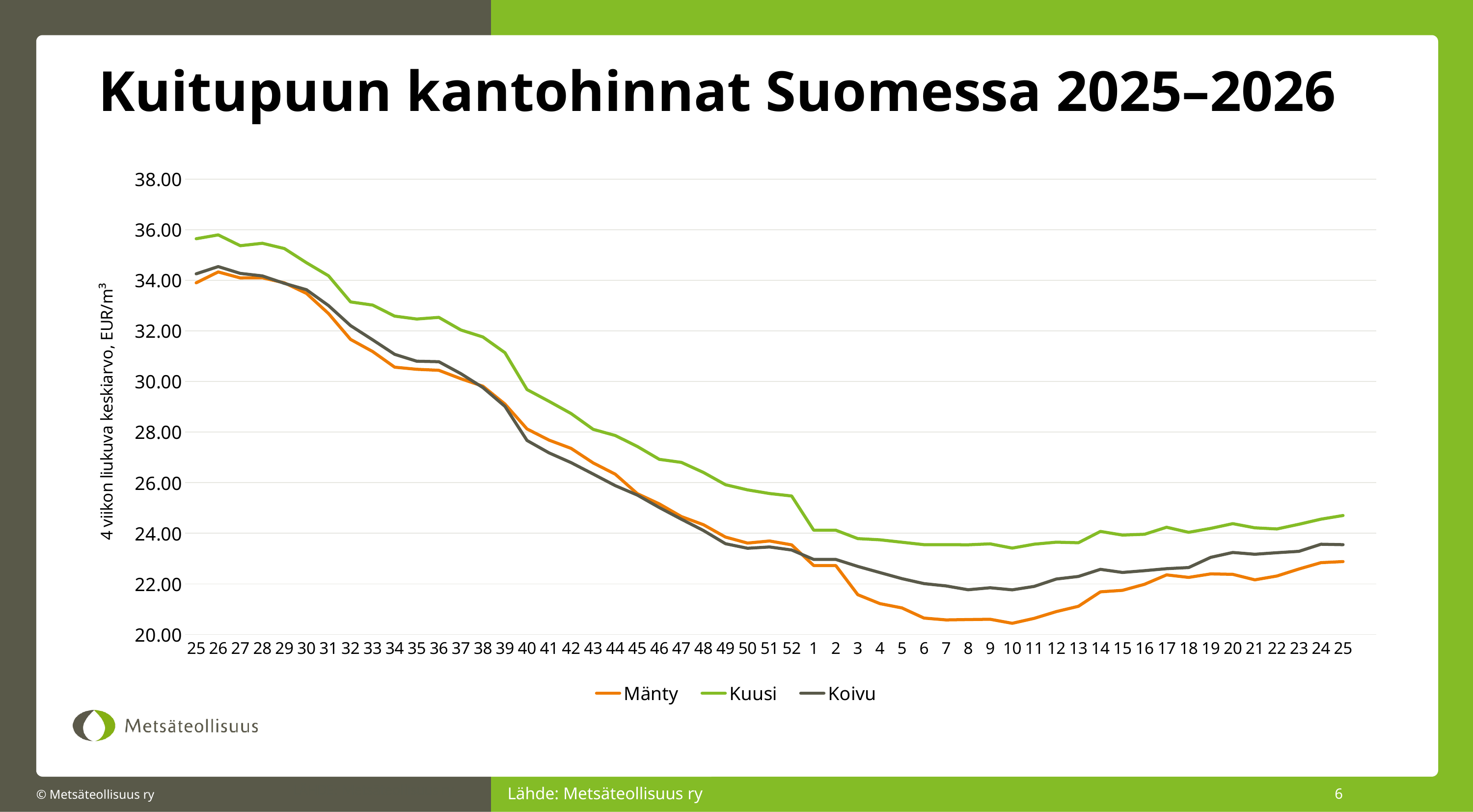
Which is larger at week 5: the value for Kuusi or the value for Koivu? Kuusi Is the value for Koivu at week 40 greater or less than 28.00? less Is the value for Kuusi at week 25 at the start of the x axis greater or less than 34.00? greater How many series does the legend list? 3 Do the values for Mänty rise or fall between week 25 and week 52? fall What kind of chart is shown on the slide? line chart Is the value for Mänty at week 10 greater or less than 22.00? less What is the title of the chart? Kuitupuun kantohinnat Suomessa 2025–2026 Which series has the highest value at week 25 at the start of the x axis? Kuusi Do the values for Koivu rise or fall between week 10 and week 25 at the end of the x axis? rise Which series has the lowest value at week 10? Mänty What is the label of the vertical axis? 4 viikon liukuva keskiarvo, EUR/m³